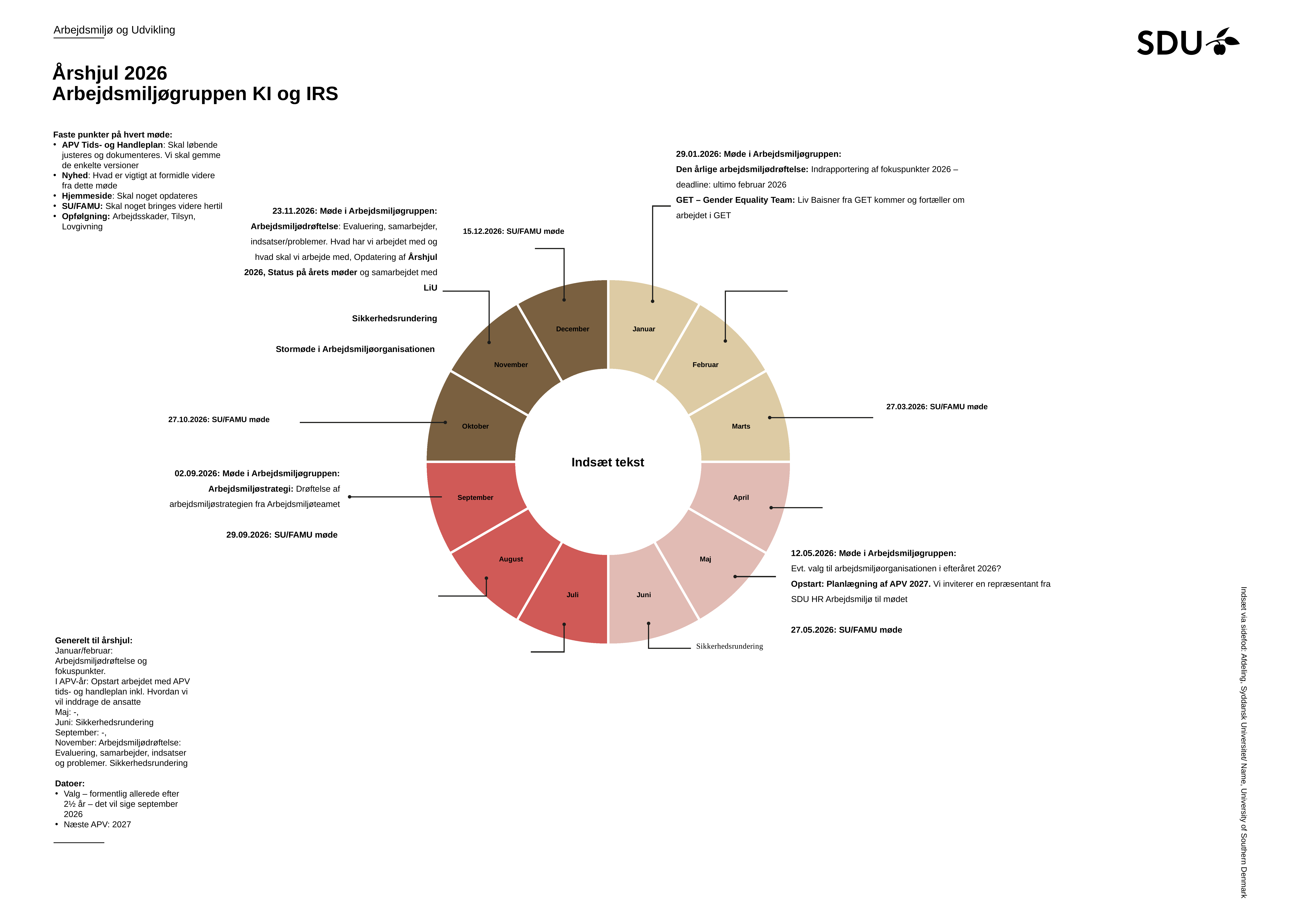
Which months are shown in the red segments of the wheel? Juli, August, September Which months are shown in the dark brown segments of the wheel? Oktober, November, December How many segments does the year wheel have? 12 Which segment of the wheel is labelled with the date 27.10.2026: SU/FAMU møde? Oktober Which segment of the wheel is labelled with the date 15.12.2026: SU/FAMU møde? December Which segment of the wheel is labelled with the date 29.01.2026: Møde i Arbejdsmiljøgruppen? Januar What text is printed in the centre of the year wheel? Indsæt tekst Which segment of the wheel is labelled with the date 02.09.2026: Møde i Arbejdsmiljøgruppen? September What kind of chart is the year wheel in the centre of the slide? doughnut chart Which segment of the wheel is labelled with the date 27.03.2026: SU/FAMU møde? Marts Which month's segment sits directly to the right of the December segment at the top of the wheel? Januar